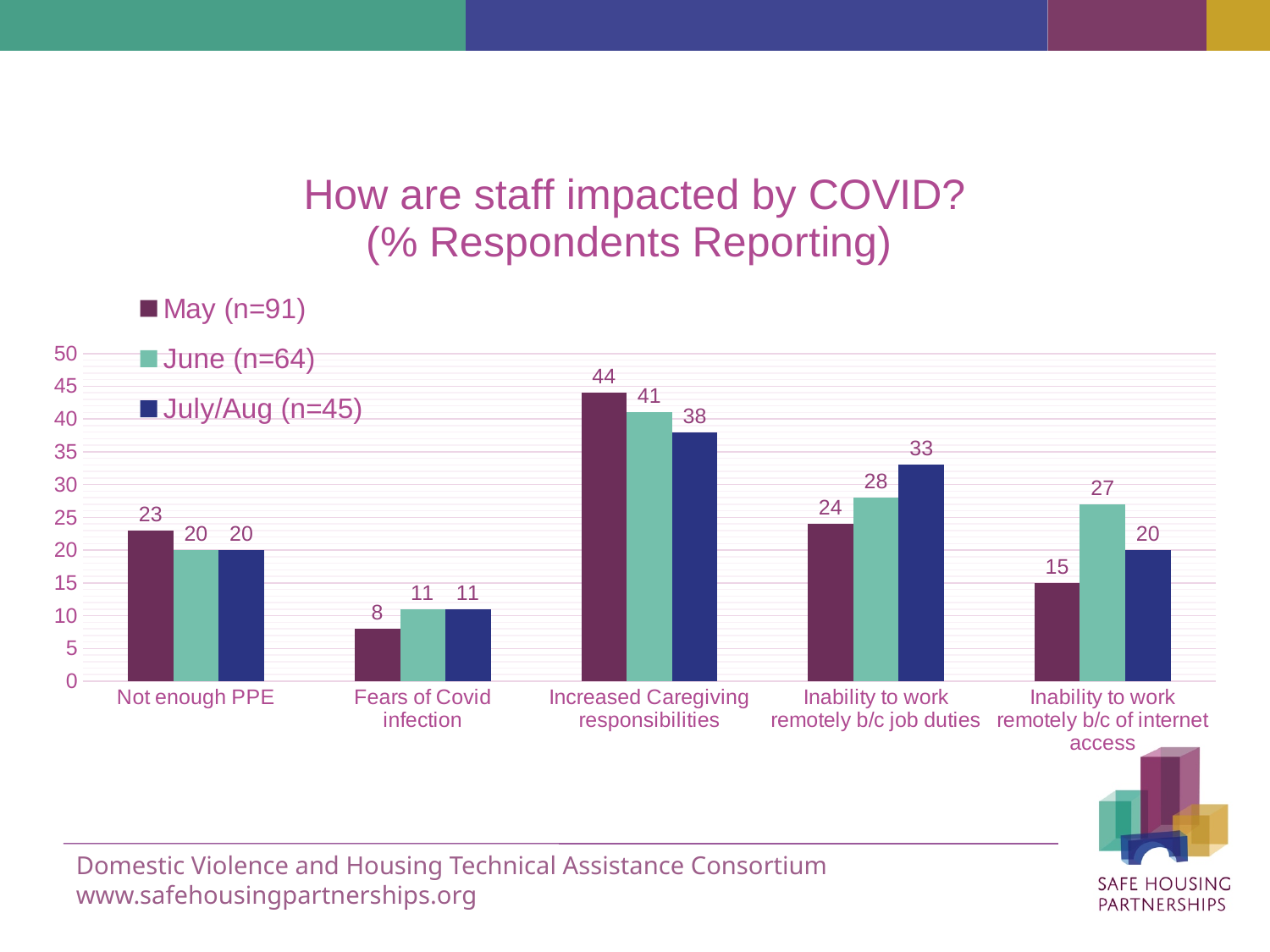
What is the difference between the May (n=91) and July/Aug (n=45) values for Increased Caregiving responsibilities? 6 What is the title of the chart? How are staff impacted by COVID? (% Respondents Reporting) What is the May (n=91) value for Increased Caregiving responsibilities? 44 Across the three series, do the values for Inability to work remotely b/c job duties rise or fall from May to July/Aug? Rise How many series does the legend list? 3 Which category has the lowest June (n=64) value? Fears of Covid infection What kind of chart is shown on the slide? Bar chart What is the July/Aug (n=45) value for Inability to work remotely b/c job duties? 33 What is the June (n=64) value for Inability to work remotely b/c of internet access? 27 Which category has the highest May (n=91) value? Increased Caregiving responsibilities How many categories are shown on the x axis? 5 Which is larger for Inability to work remotely b/c of internet access: the May (n=91) value or the June (n=64) value? June (n=64)